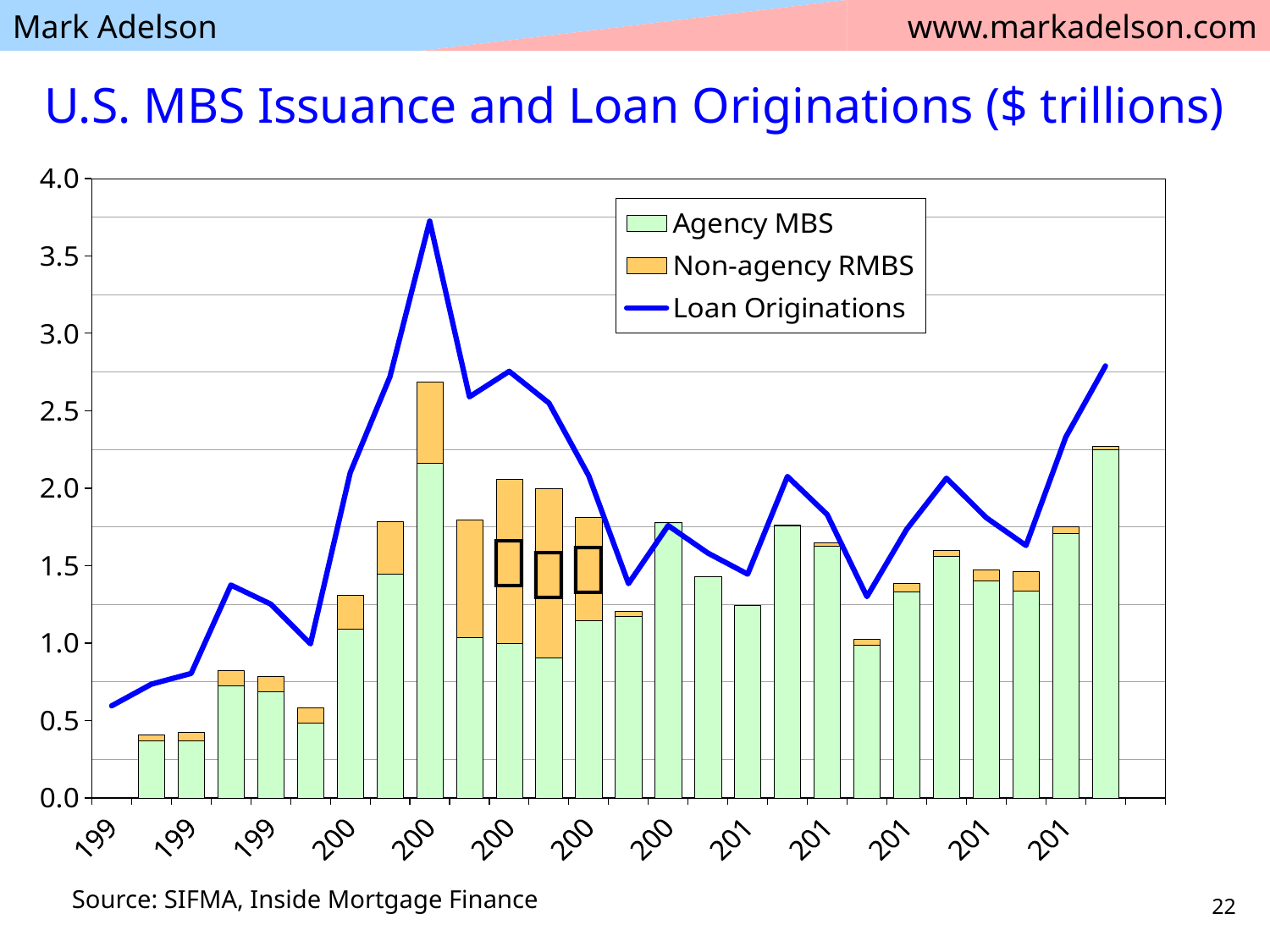
Comparing the first and last points of the Loan Originations line, does the line end higher or lower than it starts? higher Is the first (leftmost) stacked bar greater or less than 0.5? less How many series does the legend list? 3 Is the peak value of the Loan Originations line greater or less than 3.5? greater What is the highest value shown on the vertical axis? 4.0 What is the title of the chart? U.S. MBS Issuance and Loan Originations ($ trillions) Is the tallest stacked bar greater or less than 2.5? greater Which series is drawn as a line rather than bars? Loan Originations How many stacked bars are plotted on the chart? 25 What kind of chart is shown on the slide? A combined stacked bar and line chart